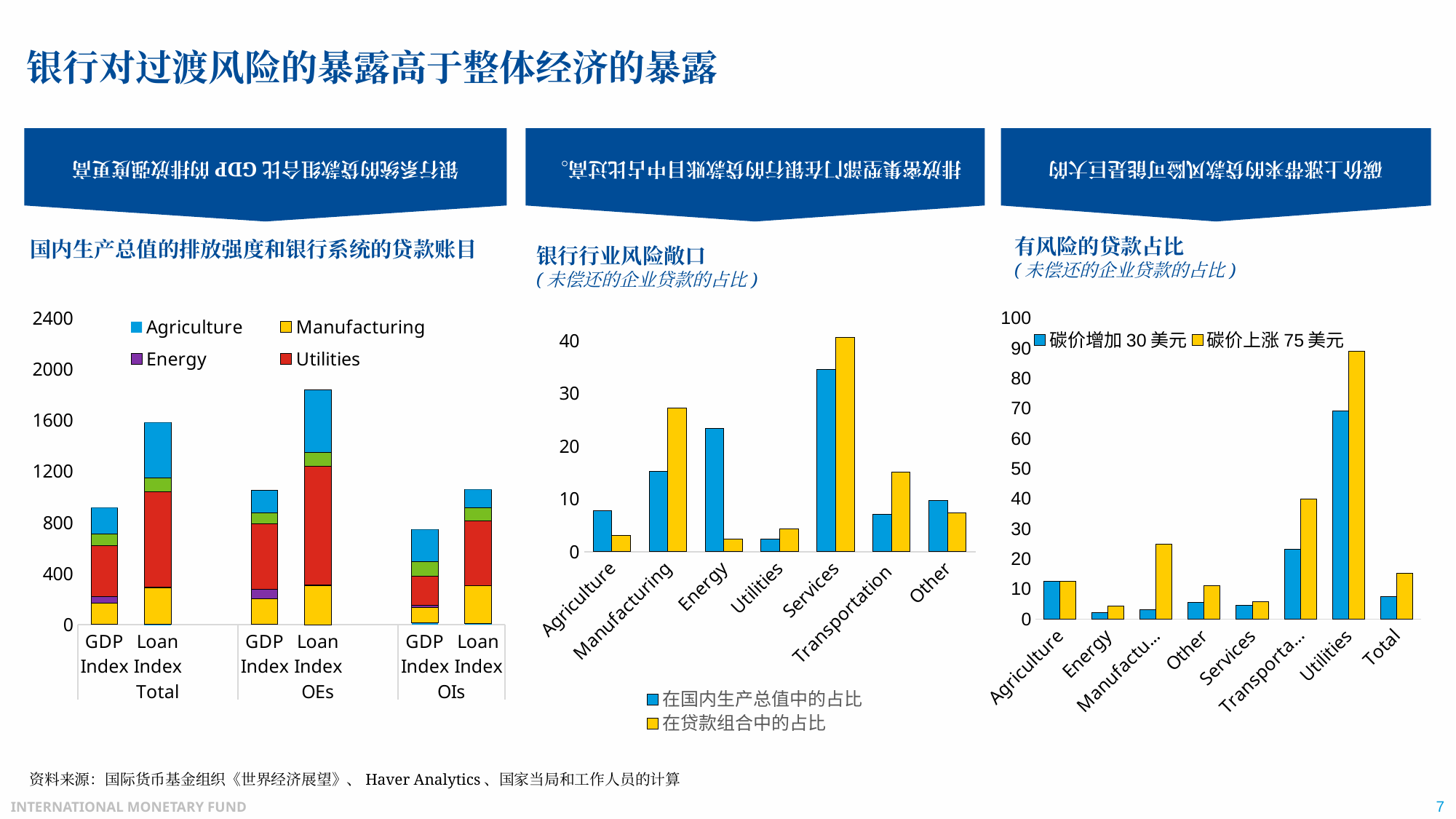
In the left chart (国内生产总值的排放强度和银行系统的贷款账目), which bar is the tallest? Loan Index (OEs) In the right chart (有风险的贷款占比), which category has the highest 碳价上涨 75 美元 value? Utilities In the right chart (有风险的贷款占比), is the 碳价增加 30 美元 value for Total greater or less than 10? less In the middle chart (银行行业风险敞口), is the 在贷款组合中的占比 value for Manufacturing greater or less than 20? greater What kind of chart is the left chart titled 国内生产总值的排放强度和银行系统的贷款账目? stacked bar chart In the right chart (有风险的贷款占比), how many series does the legend list? 2 In the middle chart (银行行业风险敞口), for Energy, which is larger: 在国内生产总值中的占比 or 在贷款组合中的占比? 在国内生产总值中的占比 In the middle chart (银行行业风险敞口), how many sectors are shown on the x axis? 7 In the left chart (国内生产总值的排放强度和银行系统的贷款账目), how many series does the legend list? 4 In the right chart (有风险的贷款占比), is the 碳价上涨 75 美元 value for Utilities greater or less than 80? greater In the middle chart (银行行业风险敞口), which sector has the highest 在贷款组合中的占比 value? Services